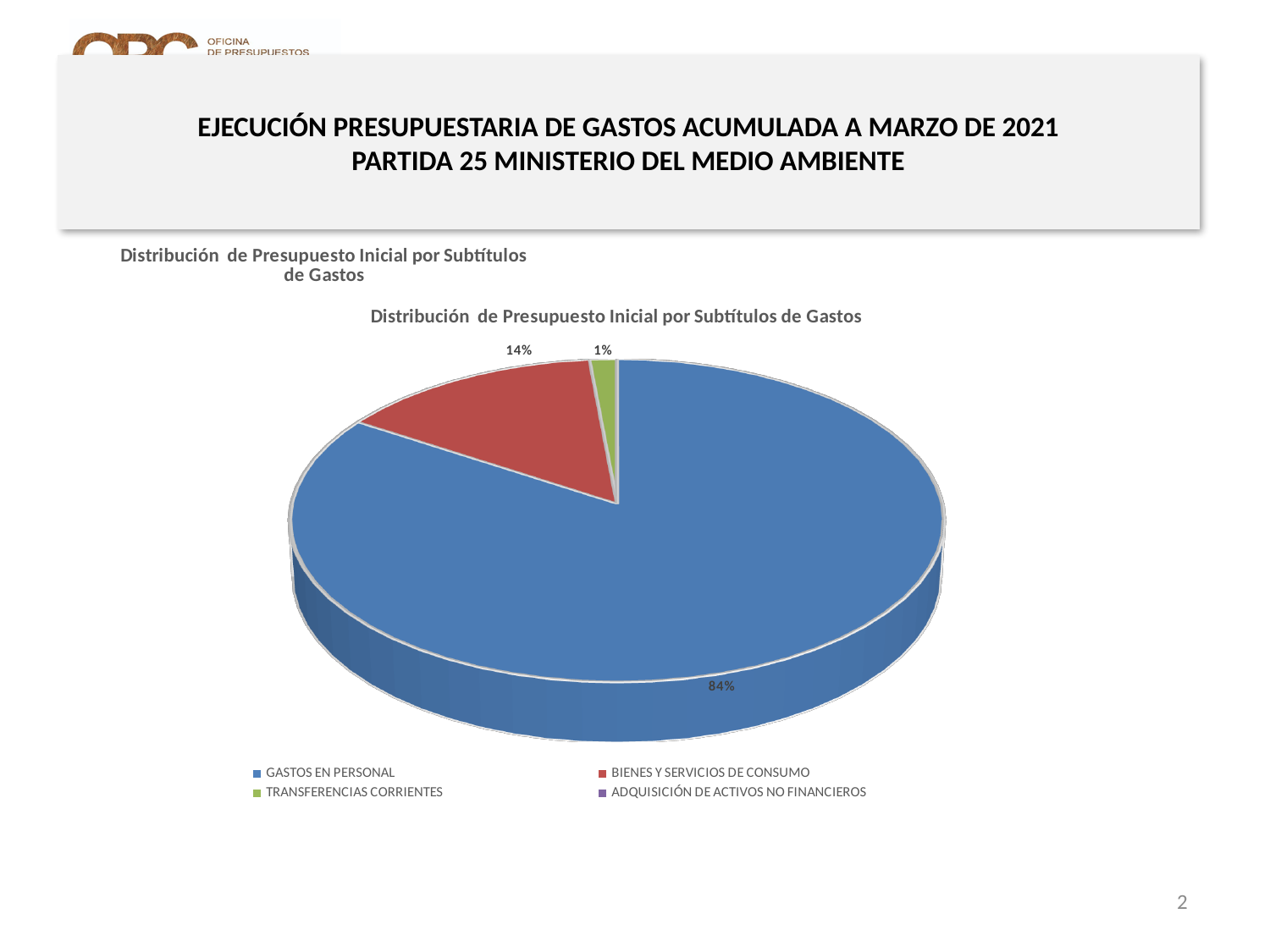
Which category has the largest slice of the pie? GASTOS EN PERSONAL By how many percentage points does GASTOS EN PERSONAL exceed BIENES Y SERVICIOS DE CONSUMO? 70 percentage points What colour is the slice for GASTOS EN PERSONAL? Blue How many categories does the legend list? 4 What kind of chart is shown on the slide? Pie chart Which is larger, the slice for BIENES Y SERVICIOS DE CONSUMO or the slice for TRANSFERENCIAS CORRIENTES? BIENES Y SERVICIOS DE CONSUMO What share of the pie does GASTOS EN PERSONAL represent? 84% What is the title of the chart? Distribución de Presupuesto Inicial por Subtítulos de Gastos What percentage is shown for BIENES Y SERVICIOS DE CONSUMO? 14% What percentage is shown for TRANSFERENCIAS CORRIENTES? 1%